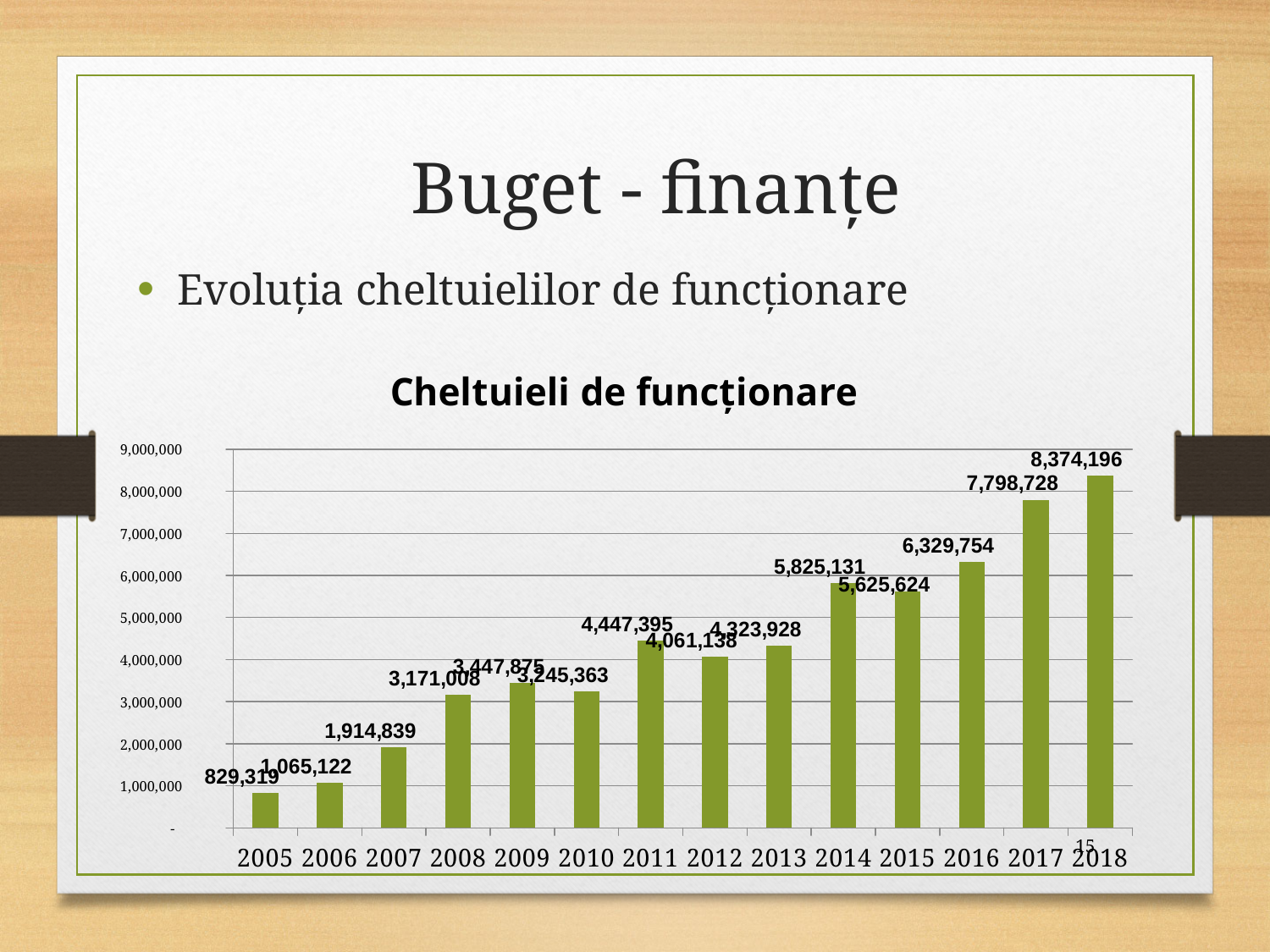
Do the values in the Cheltuieli de funcționare chart generally rise or fall from 2005 to 2018? rise Which year has the larger value in the Cheltuieli de funcționare chart, 2014 or 2015? 2014 How many years are shown in the Cheltuieli de funcționare chart? 14 What is the difference between the values for 2018 and 2017 in the Cheltuieli de funcționare chart? 575,468 What is the value for 2017 in the Cheltuieli de funcționare chart? 7,798,728 Which year has the lowest value in the Cheltuieli de funcționare chart? 2005 What is the value for 2014 in the Cheltuieli de funcționare chart? 5,825,131 Is the value for 2016 in the Cheltuieli de funcționare chart greater or less than 6,000,000? greater What is the value for 2018 in the Cheltuieli de funcționare chart? 8,374,196 Which year has the highest value in the Cheltuieli de funcționare chart? 2018 What kind of chart is the Cheltuieli de funcționare chart? bar chart What is the value for 2007 in the Cheltuieli de funcționare chart? 1,914,839